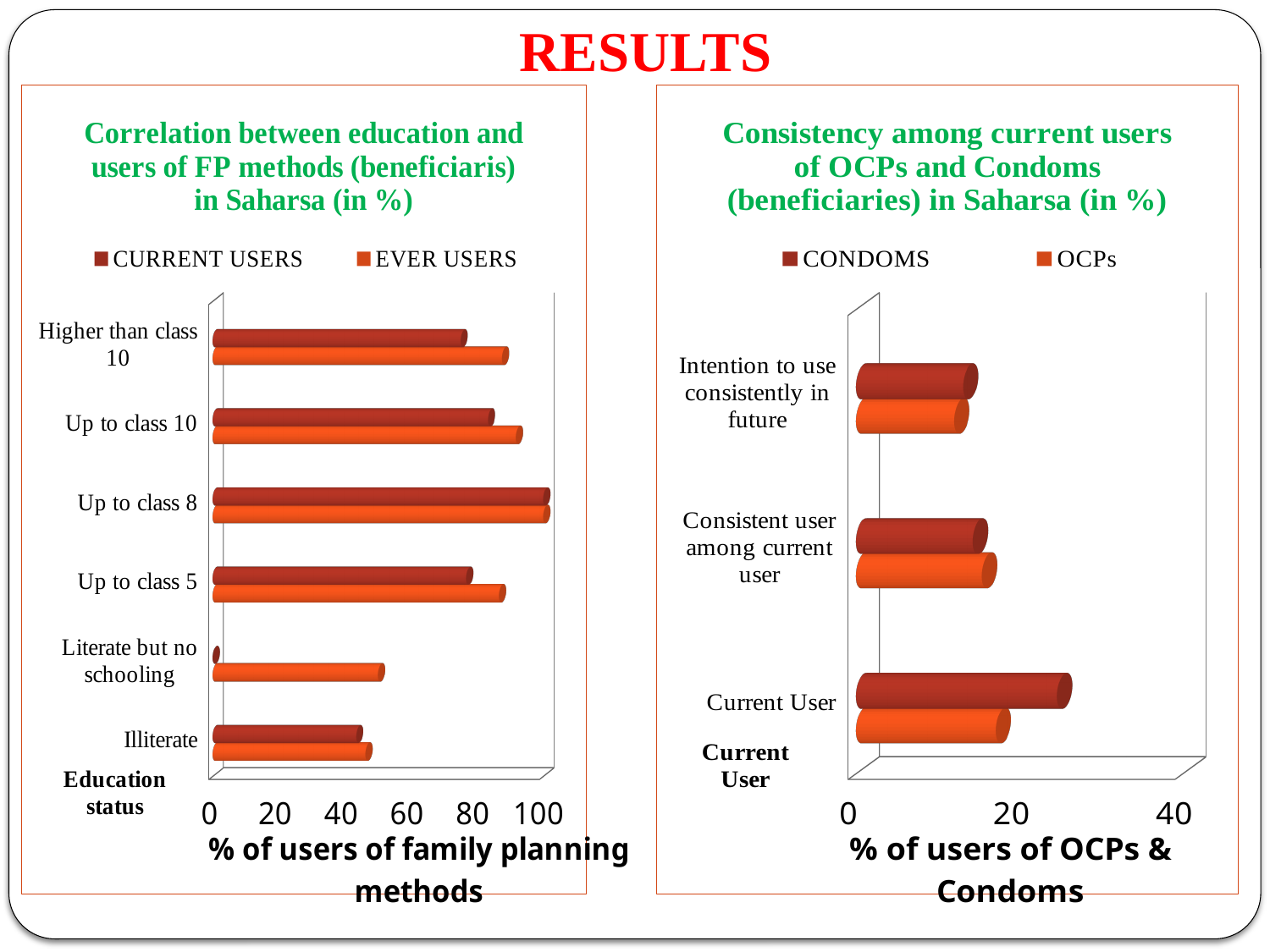
In the chart titled 'Correlation between education and users of FP methods', how many series does the legend list? 2 In the chart titled 'Consistency among current users of OCPs and Condoms', which category has the highest value for CONDOMS? Current User In the chart titled 'Consistency among current users of OCPs and Condoms', for 'Current User', which series has the larger value, CONDOMS or OCPs? CONDOMS In the chart titled 'Correlation between education and users of FP methods', is the CURRENT USERS value for 'Illiterate' greater or less than 60? less In the chart titled 'Correlation between education and users of FP methods', what kind of chart is shown? bar chart In the chart titled 'Correlation between education and users of FP methods', how many education status categories are plotted? 6 In the chart titled 'Correlation between education and users of FP methods', which education status has the lowest value for CURRENT USERS? Literate but no schooling In the chart titled 'Correlation between education and users of FP methods', is the EVER USERS value for 'Literate but no schooling' greater or less than 40? greater In the chart titled 'Correlation between education and users of FP methods', which education status has the highest value for EVER USERS? Up to class 8 In the chart titled 'Consistency among current users of OCPs and Condoms', how many categories are plotted? 3 In the chart titled 'Correlation between education and users of FP methods', for 'Higher than class 10', which series has the larger value, CURRENT USERS or EVER USERS? EVER USERS In the chart titled 'Consistency among current users of OCPs and Condoms', is the CONDOMS value for 'Current User' greater or less than 20? greater